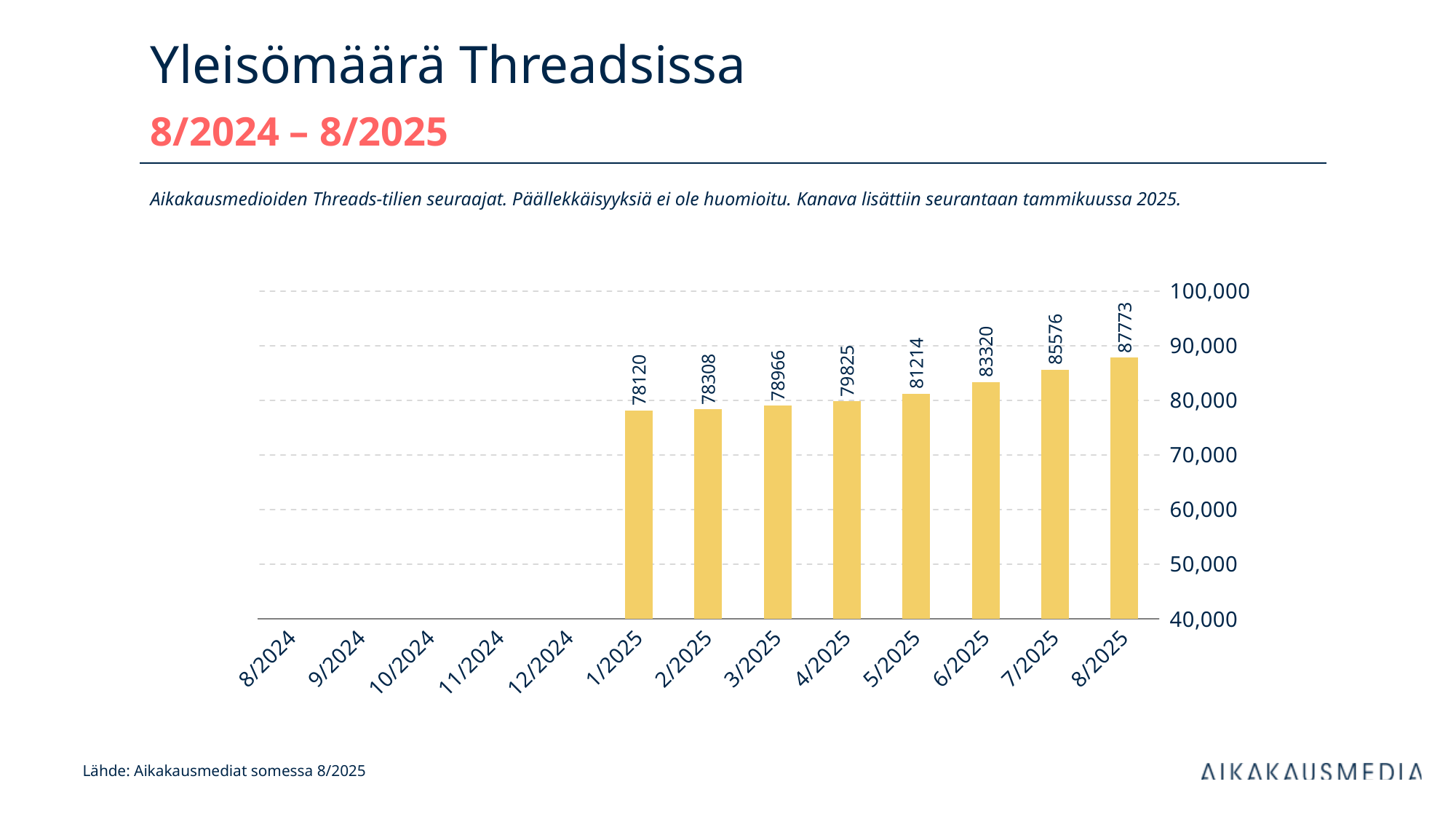
What is the difference between the values for 7/2025 and 6/2025? 2256 Do the values rise or fall from 1/2025 to 8/2025? rise What is the difference between the values for 8/2025 and 1/2025? 9653 What kind of chart is shown on the slide? bar chart How many months are labelled on the x axis? 13 Among the months with a plotted bar, which has the lowest value? 1/2025 Is the value for 6/2025 greater or less than 80,000? greater What is the value for 1/2025? 78120 Which is larger, the value for 3/2025 or the value for 4/2025? 4/2025 What is the value for 5/2025? 81214 What is the value for 8/2025? 87773 Which month has the highest value? 8/2025